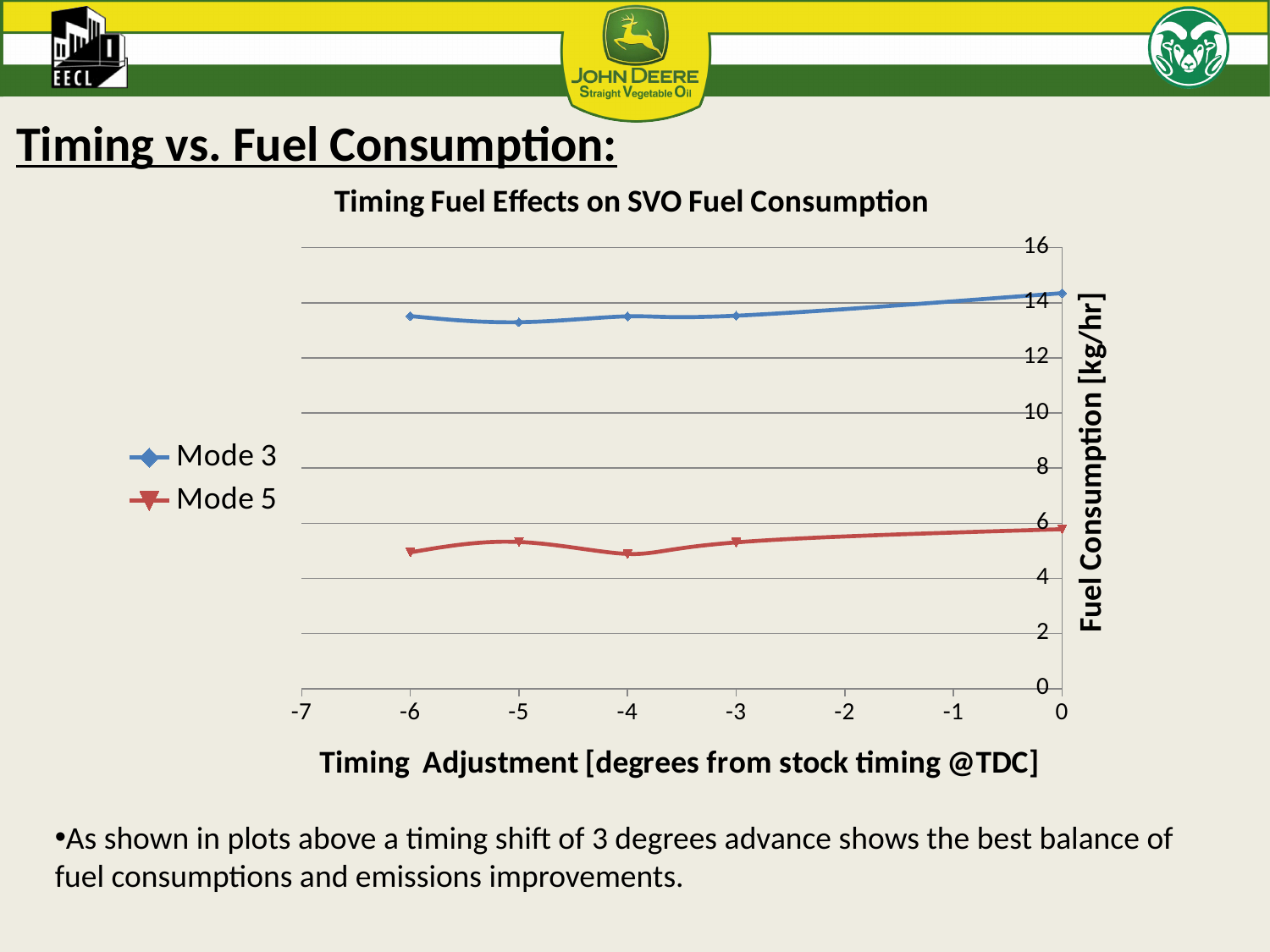
What are the names of the two series in the legend? Mode 3 and Mode 5 How many data points are plotted for the Mode 3 series? 5 Does the Mode 3 fuel consumption rise or fall overall from a timing adjustment of -6 to 0? rise Is the Mode 3 value at a timing adjustment of -6 greater or less than 12? greater At a timing adjustment of -3, which series has the higher fuel consumption, Mode 3 or Mode 5? Mode 3 Is the Mode 3 value at a timing adjustment of 0 greater or less than 14? greater Is the Mode 5 value at a timing adjustment of 0 greater or less than 4? greater What kind of chart is shown on the slide? Line chart What is the title of the chart? Timing Fuel Effects on SVO Fuel Consumption How many series does the legend list? 2 At which timing adjustment does the Mode 3 series reach its highest fuel consumption? 0